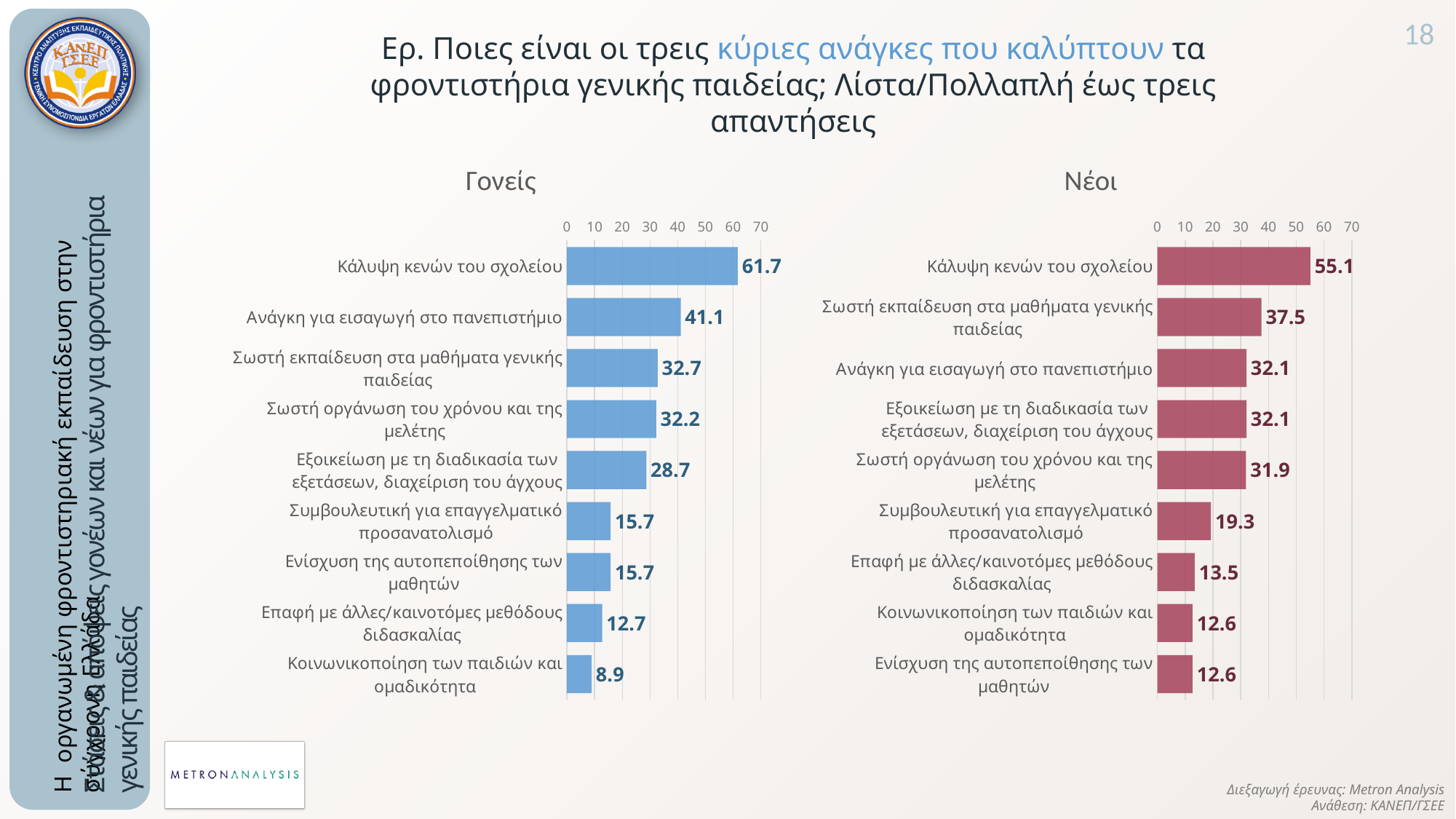
In the Γονείς chart, what is the value for Κάλυψη κενών του σχολείου? 61.7 In the Νέοι chart, which category has the highest value? Κάλυψη κενών του σχολείου What type of chart is the Γονείς chart? Bar chart What colour are the bars in the Νέοι chart? Red How many categories are shown in the Νέοι chart? 9 In the Γονείς chart, which category has the lowest value? Κοινωνικοποίηση των παιδιών και ομαδικότητα In the Γονείς chart, what is the difference between Ανάγκη για εισαγωγή στο πανεπιστήμιο and Σωστή εκπαίδευση στα μαθήματα γενικής παιδείας? 8.4 Which is larger: Ανάγκη για εισαγωγή στο πανεπιστήμιο in the Γονείς chart or in the Νέοι chart? Γονείς In the Νέοι chart, what is the value for Σωστή εκπαίδευση στα μαθήματα γενικής παιδείας? 37.5 What is the difference between the value for Κάλυψη κενών του σχολείου in the Γονείς chart and in the Νέοι chart? 6.6 In the Γονείς chart, what is the value for Ανάγκη για εισαγωγή στο πανεπιστήμιο? 41.1 In the Νέοι chart, what is the value for Συμβουλευτική για επαγγελματικό προσανατολισμό? 19.3